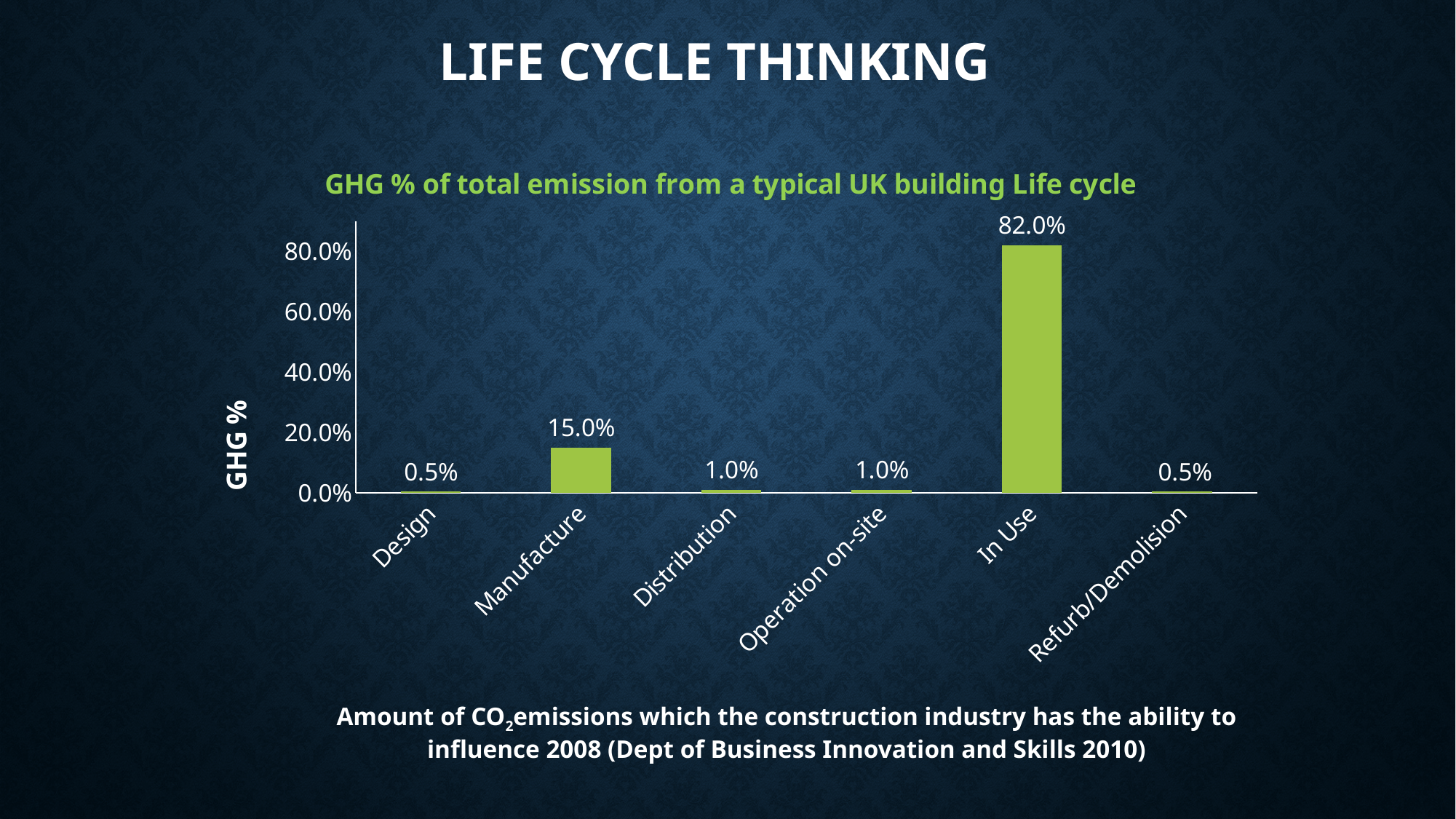
What is the GHG % value for Manufacture? 15.0% Is the value for In Use greater or less than 80.0%? greater How many life cycle stages are shown on the x axis? 6 What is the difference in GHG % between In Use and Manufacture? 67.0% What is the GHG % value for In Use? 82.0% Which life cycle stage has the highest GHG %? In Use Which has a larger GHG %, Manufacture or Distribution? Manufacture What is the label on the vertical axis of the chart? GHG % What is the GHG % value for Distribution? 1.0% What is the title of the chart? GHG % of total emission from a typical UK building Life cycle What kind of chart is shown on the slide? Bar chart What is the GHG % value for Design? 0.5%